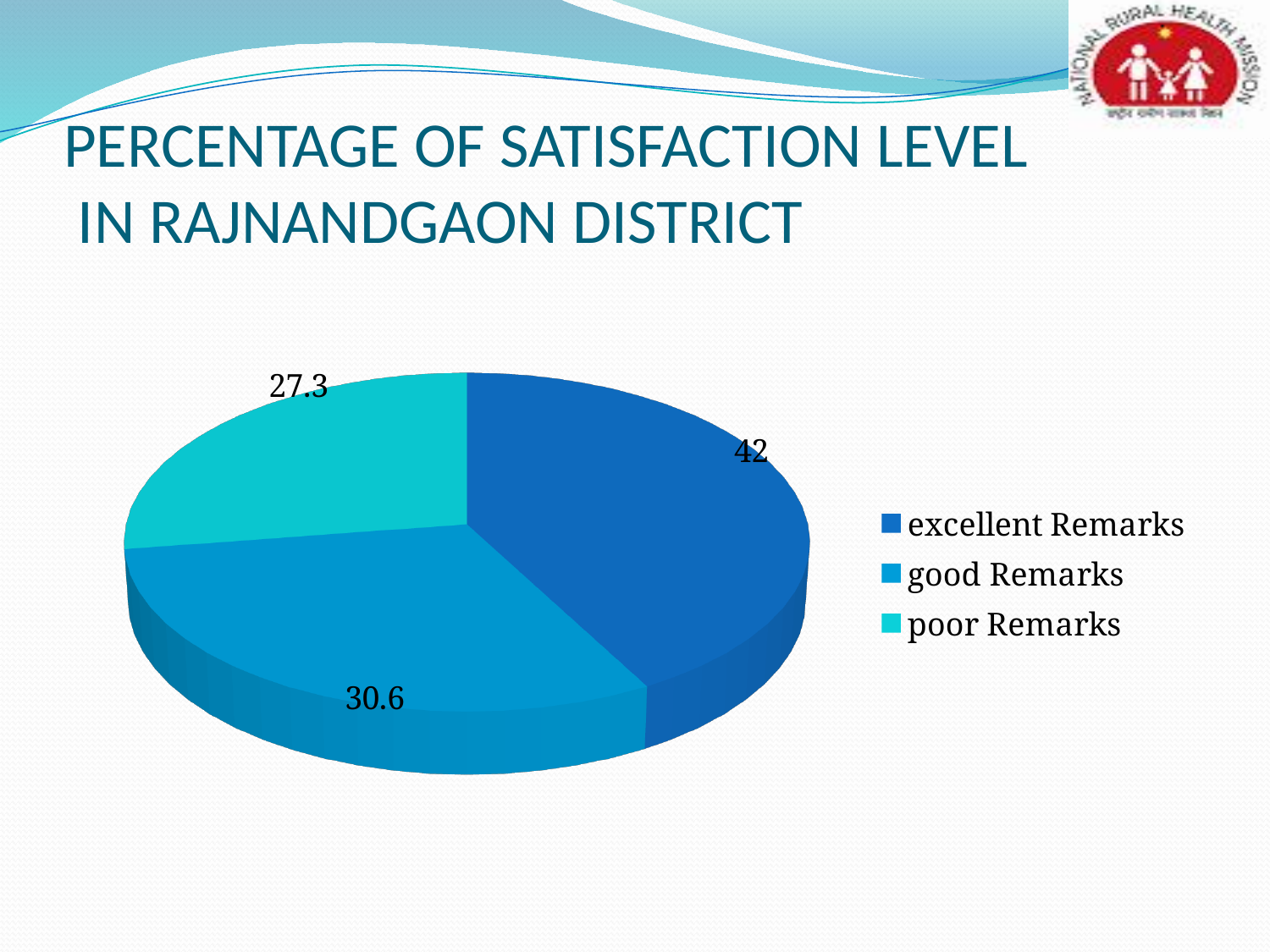
Which is larger, the value for good Remarks or the value for poor Remarks? good Remarks How many slices does the pie chart have? 3 What is the difference between the excellent Remarks value and the good Remarks value? 11.4 Which category has the smallest slice of the pie? poor Remarks What kind of chart is shown on the slide? pie chart How many entries does the legend list? 3 What value is shown for the excellent Remarks slice? 42 What is the title of the slide containing the chart? PERCENTAGE OF SATISFACTION LEVEL IN RAJNANDGAON DISTRICT What is the difference between the good Remarks value and the poor Remarks value? 3.3 Which category has the largest slice of the pie? excellent Remarks What value is shown for the poor Remarks slice? 27.3 What value is shown for the good Remarks slice? 30.6